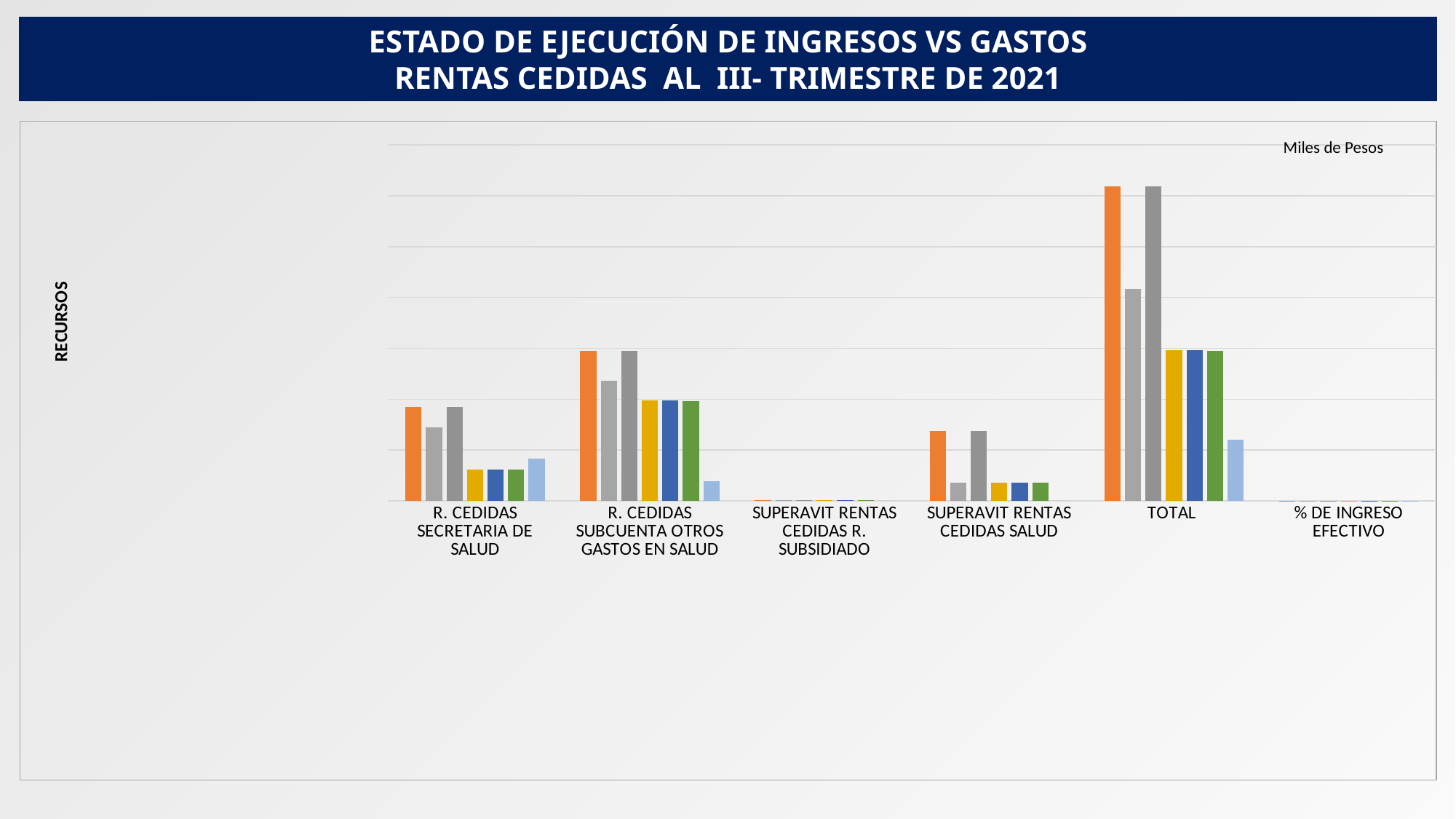
Which category has the tallest bars in the chart? TOTAL How many categories are shown along the x axis of the chart? 6 Is the orange bar for SUPERAVIT RENTAS CEDIDAS SALUD taller or shorter than the orange bar for TOTAL? Shorter What type of chart is shown on the slide? Bar chart Is the orange bar for R. CEDIDAS SUBCUENTA OTROS GASTOS EN SALUD taller or shorter than the orange bar for R. CEDIDAS SECRETARIA DE SALUD? Taller What label is shown on the vertical axis of the chart? RECURSOS Which category has taller bars: R. CEDIDAS SECRETARIA DE SALUD or R. CEDIDAS SUBCUENTA OTROS GASTOS EN SALUD? R. CEDIDAS SUBCUENTA OTROS GASTOS EN SALUD How many bars are plotted for the TOTAL category? 7 What is the title of the slide containing the chart? ESTADO DE EJECUCIÓN DE INGRESOS VS GASTOS RENTAS CEDIDAS AL III- TRIMESTRE DE 2021